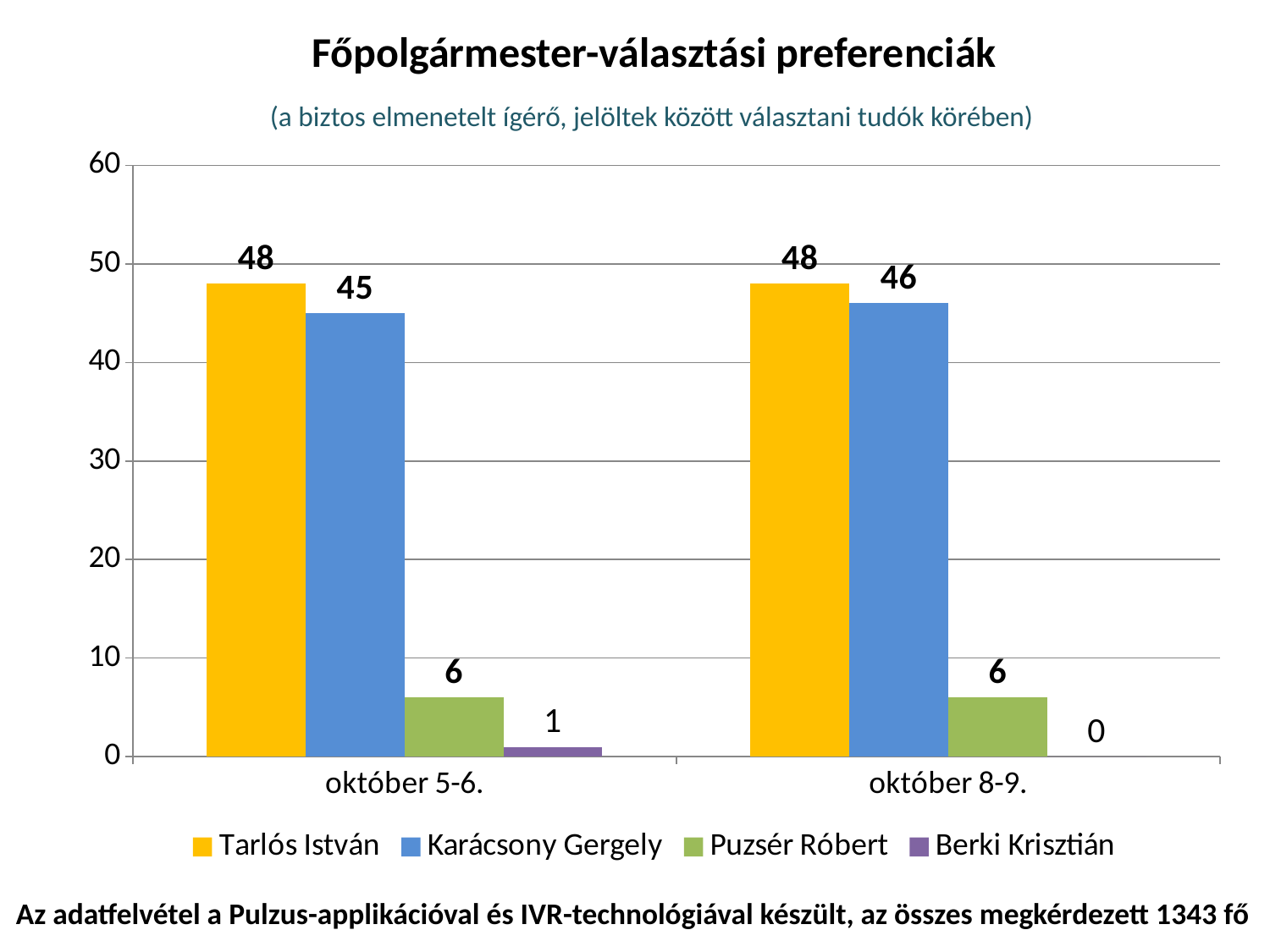
How many categories are shown on the x axis? 2 Does the value for Karácsony Gergely rise or fall from október 5-6. to október 8-9.? Rise Which is larger in the október 8-9. group: Tarlós István or Karácsony Gergely? Tarlós István What is the difference between Tarlós István and Karácsony Gergely in the október 5-6. group? 3 What is the value for Tarlós István in the október 5-6. group? 48 Which candidate has the lowest value in the október 5-6. group? Berki Krisztián How many series does the legend list? 4 What is the value for Puzsér Róbert in the október 8-9. group? 6 What kind of chart is shown on the slide? Bar chart Which candidate has the highest value in the október 8-9. group? Tarlós István What is the value for Karácsony Gergely in the október 8-9. group? 46 What is the value for Berki Krisztián in the október 5-6. group? 1